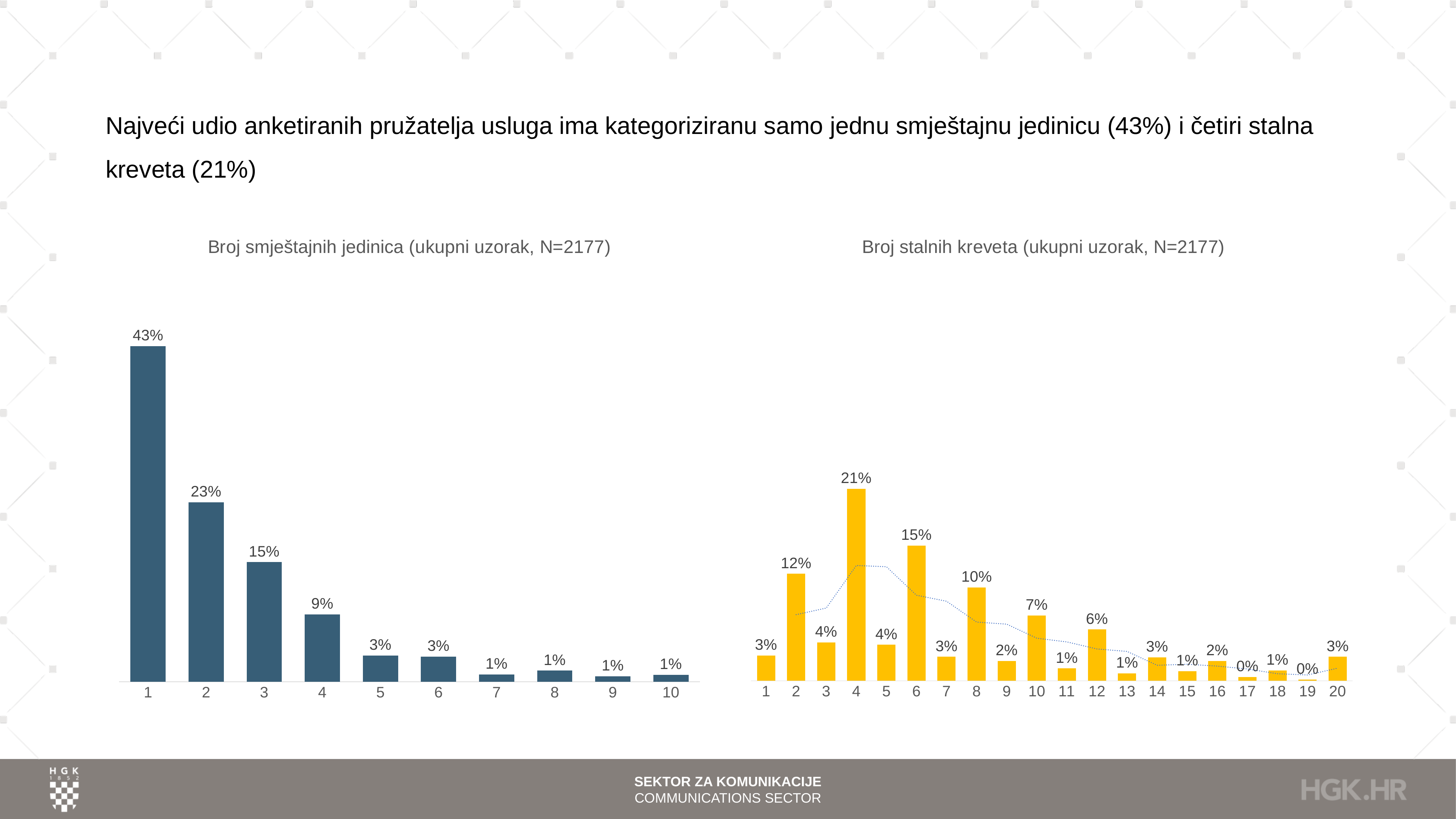
In the chart 'Broj stalnih kreveta (ukupni uzorak, N=2177)', what is the value for category 8? 10% In the chart 'Broj stalnih kreveta (ukupni uzorak, N=2177)', which category has the highest value? 4 In the chart 'Broj smještajnih jedinica (ukupni uzorak, N=2177)', what is the value for category 4? 9% In the chart 'Broj stalnih kreveta (ukupni uzorak, N=2177)', how many categories are shown on the x axis? 20 In the chart 'Broj smještajnih jedinica (ukupni uzorak, N=2177)', what is the difference between the values for categories 1 and 2? 20% In the chart 'Broj smještajnih jedinica (ukupni uzorak, N=2177)', which category has the highest value? 1 In the chart 'Broj smještajnih jedinica (ukupni uzorak, N=2177)', what is the value for category 1? 43% In the chart 'Broj stalnih kreveta (ukupni uzorak, N=2177)', which is larger, the value for category 6 or the value for category 2? 6 What type of chart is 'Broj smještajnih jedinica (ukupni uzorak, N=2177)'? bar chart In the chart 'Broj smještajnih jedinica (ukupni uzorak, N=2177)', do the values generally rise or fall from category 1 to category 10? fall In the chart 'Broj stalnih kreveta (ukupni uzorak, N=2177)', what is the value for category 4? 21% In the chart 'Broj smještajnih jedinica (ukupni uzorak, N=2177)', how many categories are shown on the x axis? 10